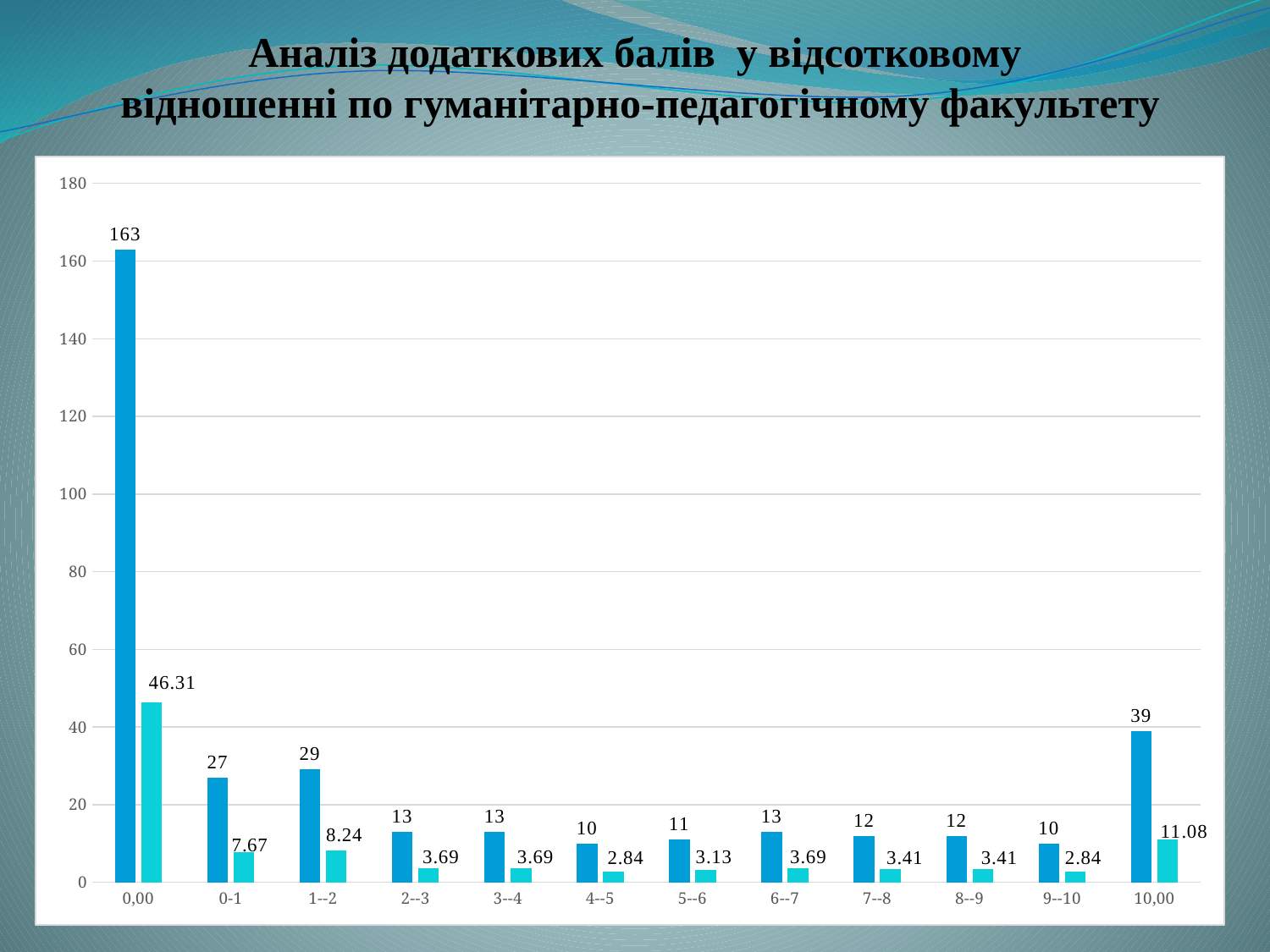
What is the difference between the dark blue bars for 10,00 and 1--2? 10 What is the value of the light blue bar for the category 1--2? 8.24 Is the value of the light blue bar for 0,00 greater or less than 40? greater What kind of chart is shown on the slide? bar chart Which category has the highest dark blue bar? 0,00 What is the value of the light blue bar for the category 10,00? 11.08 What is the maximum value shown on the y axis? 180 Which category has the lowest light blue bar? 4--5 and 9--10 (both 2.84) How many categories are shown on the x axis? 12 What is the value of the dark blue bar for the category 9--10? 10 What is the value of the dark blue bar for the category 0,00? 163 Which is larger, the dark blue bar for 0-1 or the dark blue bar for 1--2? 1--2